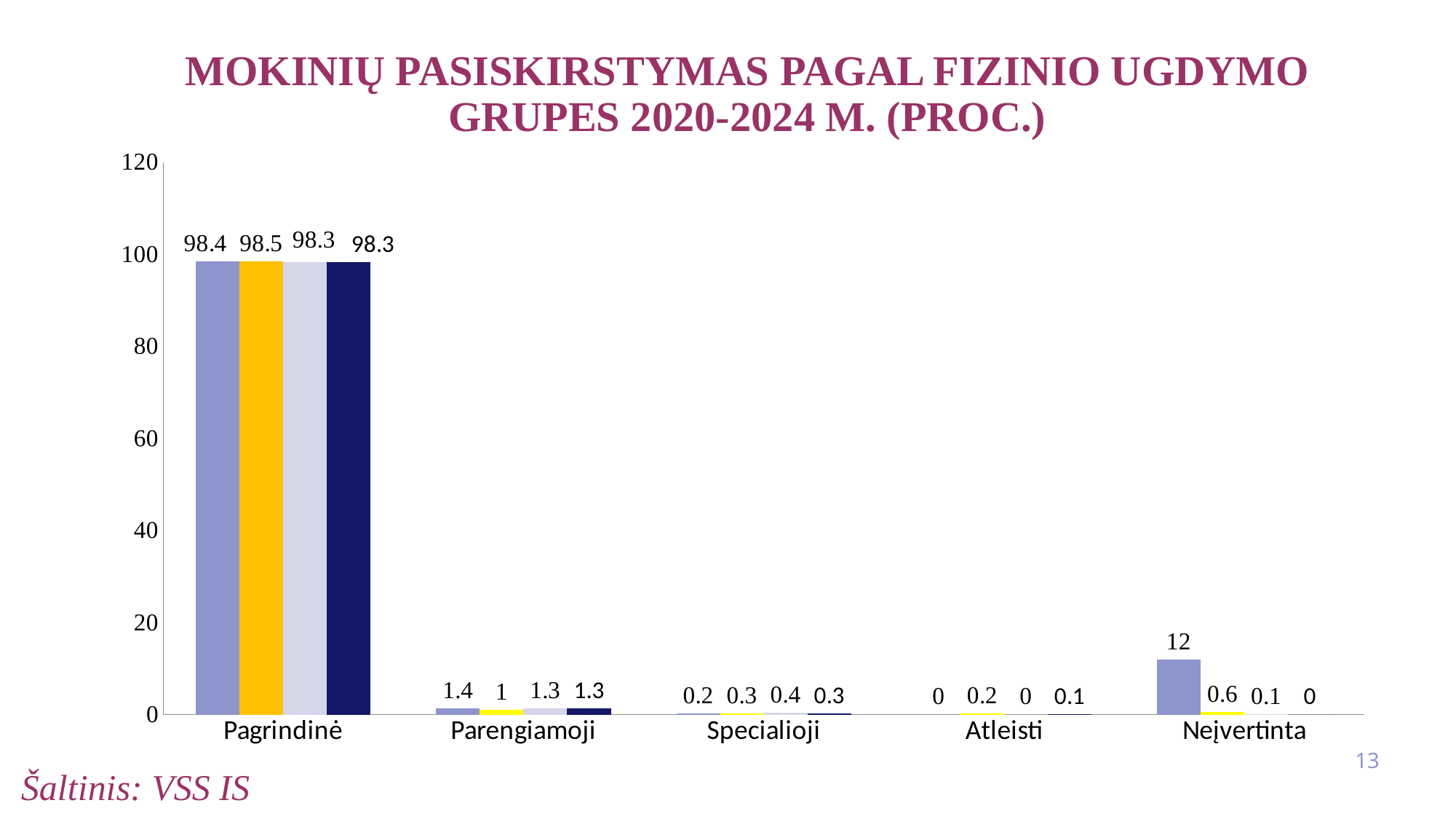
What is the title of the chart? MOKINIŲ PASISKIRSTYMAS PAGAL FIZINIO UGDYMO GRUPES 2020-2024 M. (PROC.) Which category has the highest values overall? Pagrindinė Which is larger: the first bar in Parengiamoji or the first bar in Specialioji? Parengiamoji What is the value of the yellow bar in the Parengiamoji category? 1 What is the value of the first (leftmost) bar in the Pagrindinė category? 98.4 How many categories are shown on the x axis? 5 What is the value of the first (leftmost) bar in the Neįvertinta category? 12 What kind of chart is shown on the slide? bar chart What is the value of the dark navy (rightmost) bar in the Atleisti category? 0.1 Is the value of the first bar in the Neįvertinta category greater or less than 20? less What is the value of the yellow bar in the Pagrindinė category? 98.5 What is the difference between the first bar in Neįvertinta (12) and the yellow bar in Neįvertinta (0.6)? 11.4